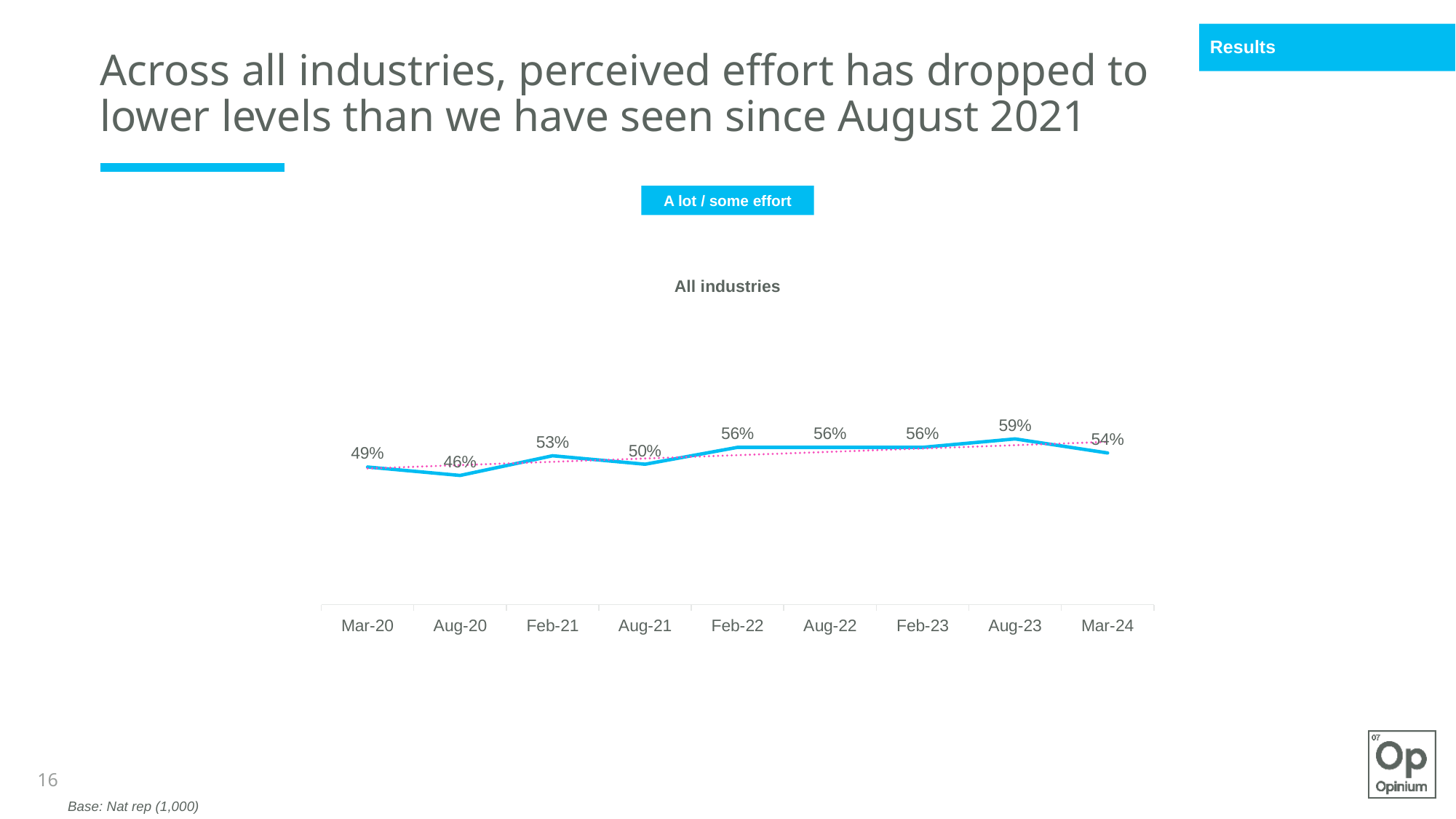
What kind of chart is the All industries chart? Line chart How many time periods are shown on the x axis of the All industries chart? 9 What is the value for Mar-24 in the All industries chart? 54% Which period has the lowest value in the All industries chart? Aug-20 Which period has the highest value in the All industries chart? Aug-23 What is the title of the chart on the slide? All industries What is the value for Mar-20 in the All industries chart? 49% What is the value for Aug-23 in the All industries chart? 59% What is the difference between the Aug-23 and Mar-24 values in the All industries chart? 5 percentage points Which is larger in the All industries chart: the value for Feb-21 or the value for Aug-21? Feb-21 What is the value for Aug-20 in the All industries chart? 46% Does the value rise or fall from Aug-23 to Mar-24 in the All industries chart? Fall